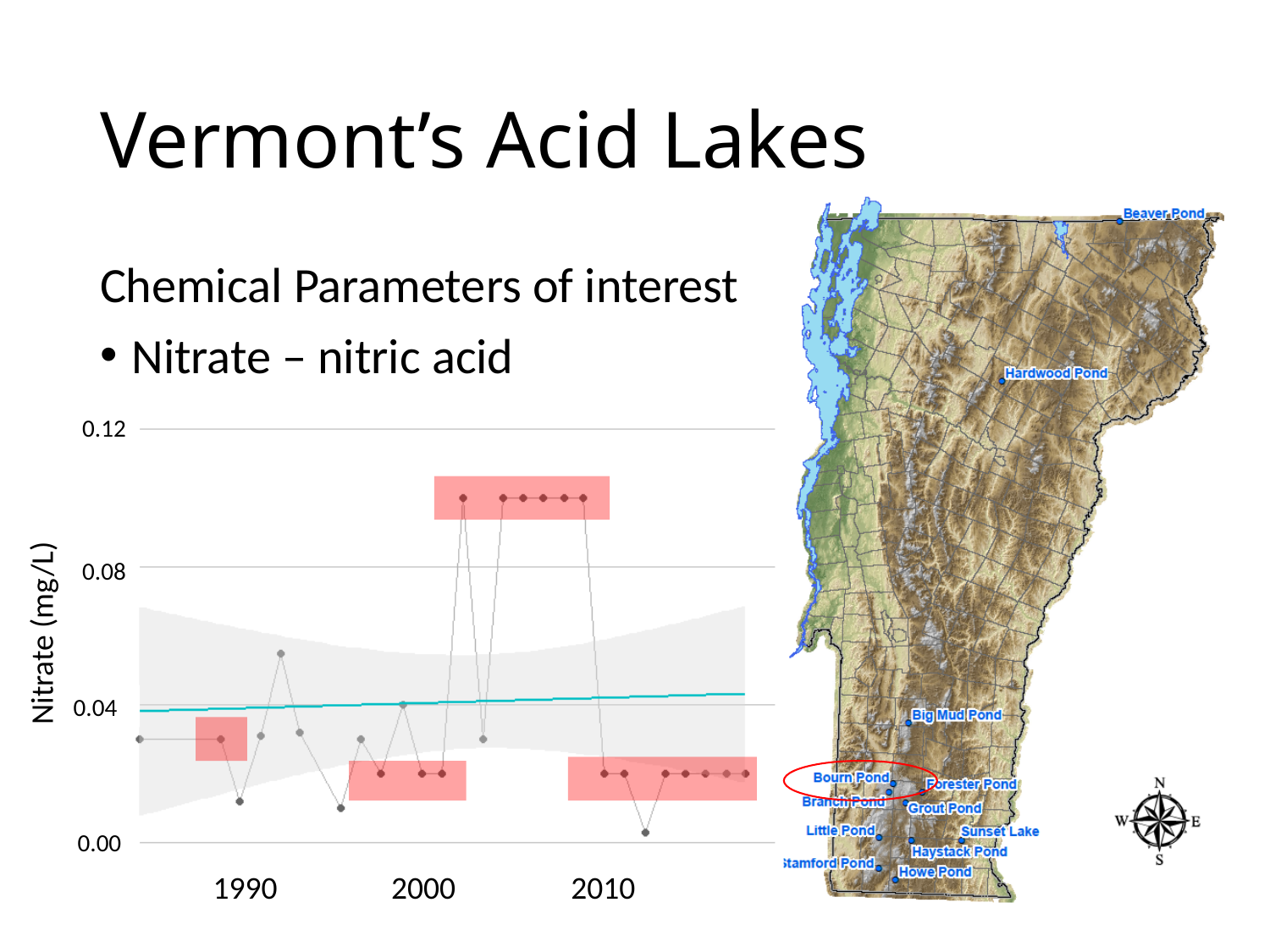
How many year labels are shown on the x axis of the chart? 3 Does the smooth trend line on the chart rise or fall from left to right? rise What kind of chart is shown on the slide? line chart What is the highest value shown on the y axis of the chart? 0.12 Is the trend line on the chart above or below 0.08 across the whole x axis? below Are the highest plotted nitrate points on the chart greater or less than 0.08? greater What is the label on the y axis of the chart? Nitrate (mg/L) Is the lowest plotted nitrate point on the chart greater or less than 0.04? less